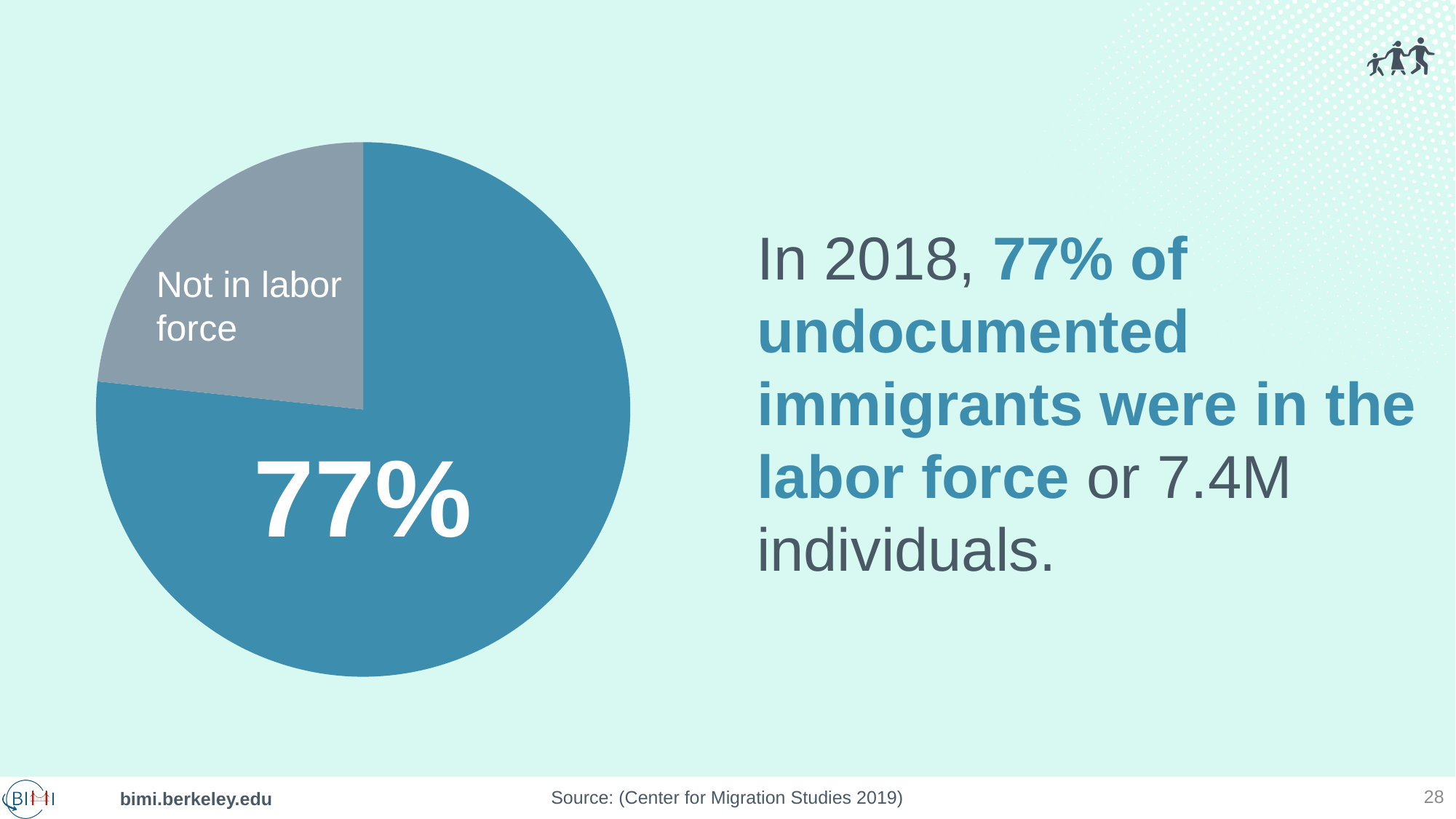
What colour is the slice labelled 77%? Blue What kind of chart is shown on the slide? Pie chart Which slice of the pie chart is the smallest? Not in labor force How many slices does the pie chart have? 2 Which slice of the pie chart is the largest? The 77% slice (in the labor force) Is the 'Not in labor force' slice greater or less than half of the pie? less What percentage is printed on the large blue slice of the pie chart? 77% What is the label on the gray slice of the pie chart? Not in labor force Which is larger in the pie chart: the share in the labor force or the share not in the labor force? In the labor force What share of the pie does the blue slice (in the labor force) represent? 77%